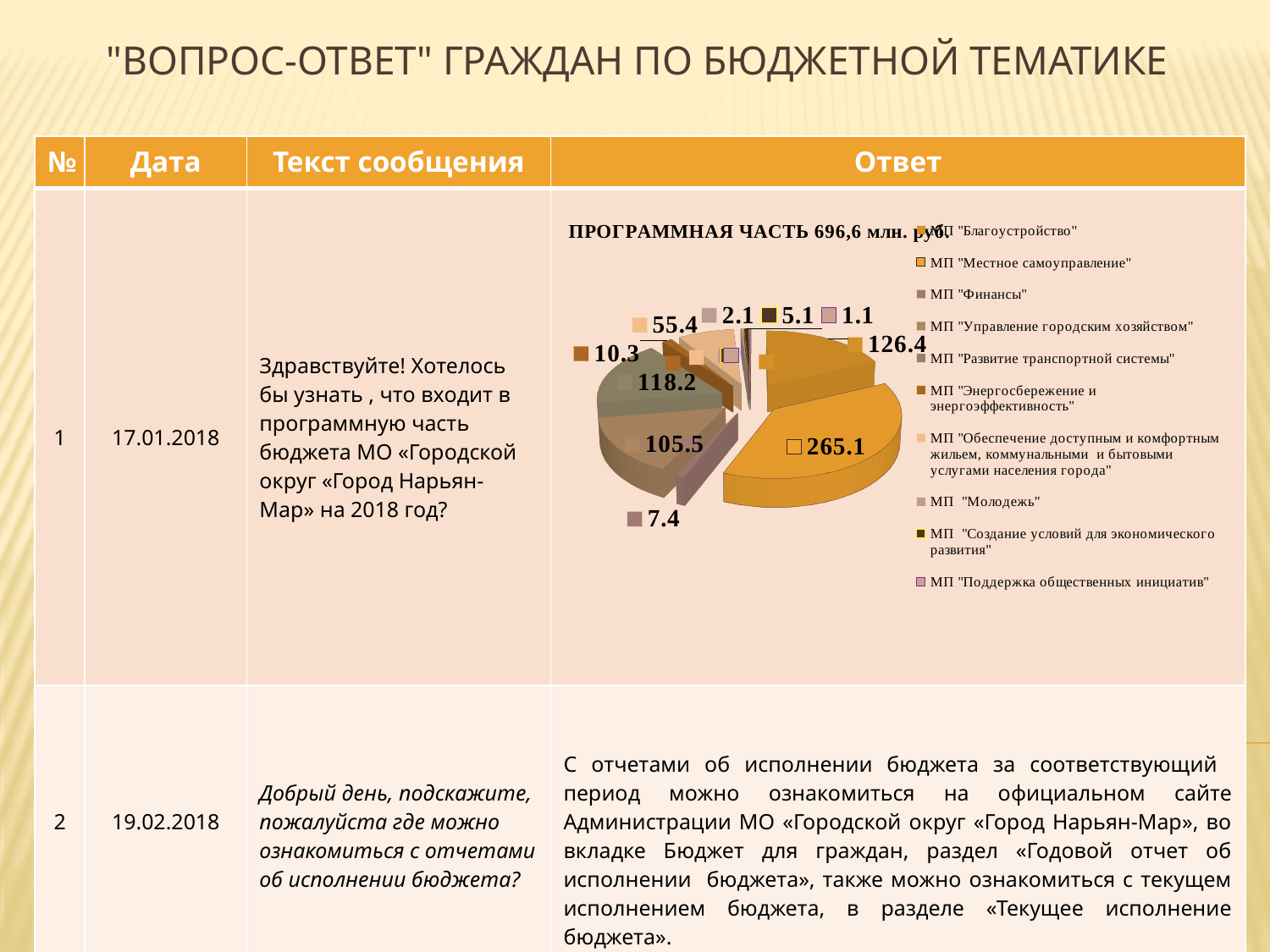
Which slice of the pie chart is larger, the one labelled 118.2 or the one labelled 105.5? 118.2 What is the title of the pie chart on the slide? ПРОГРАММНАЯ ЧАСТЬ 696,6 млн. руб. What is the difference between the two largest slices of the pie chart, 265.1 and 126.4? 138.7 What is the smallest value labelled on the pie chart? 1.1 What is the largest value labelled on the pie chart? 265.1 What is the difference between the slices labelled 118.2 and 105.5 on the pie chart? 12.7 How many slices does the pie chart have? 10 What is the difference between the slices labelled 10.3 and 7.4 on the pie chart? 2.9 How many entries does the legend of the pie chart list? 10 What share of the total 696.6 does the largest slice (265.1) of the pie chart represent, to one decimal place? 38.1% What kind of chart is shown in the answer to question 1? pie chart What total amount of the programme part of the budget is stated in the pie chart title? 696,6 млн. руб.